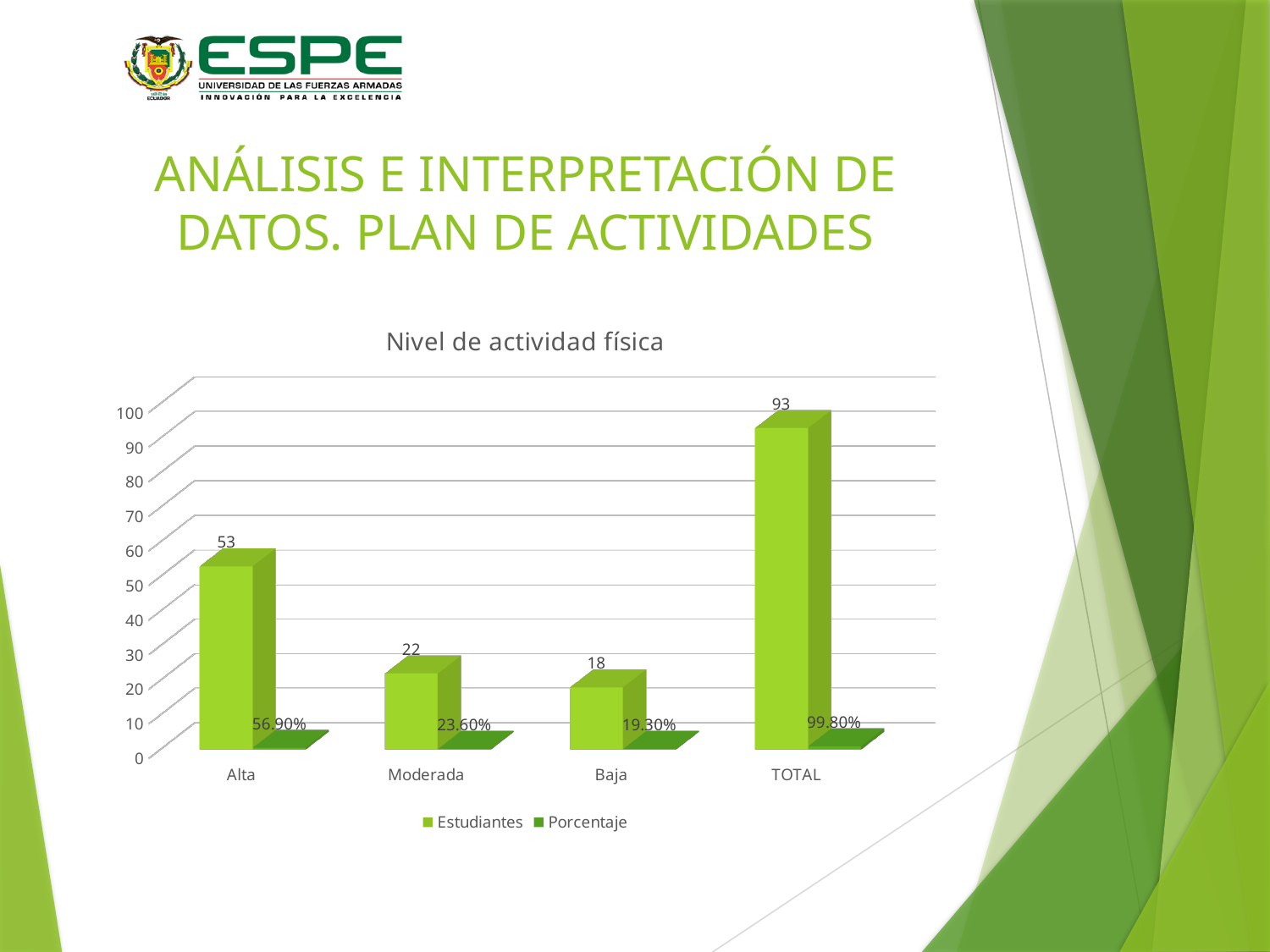
What is the title of the chart? Nivel de actividad física What is the Porcentaje value for TOTAL? 99.80% What is the Estudiantes value for Alta? 53 Which category has the lowest Estudiantes value? Baja Which is larger, the Estudiantes value for Moderada or for Baja? Moderada How many series does the legend list? 2 What kind of chart is shown? Bar chart How many categories are shown on the x axis? 4 What is the difference between the Estudiantes values for Alta and Moderada? 31 What is the Porcentaje value for Moderada? 23.60% What is the Estudiantes value for Baja? 18 Which category has the highest Estudiantes value? TOTAL